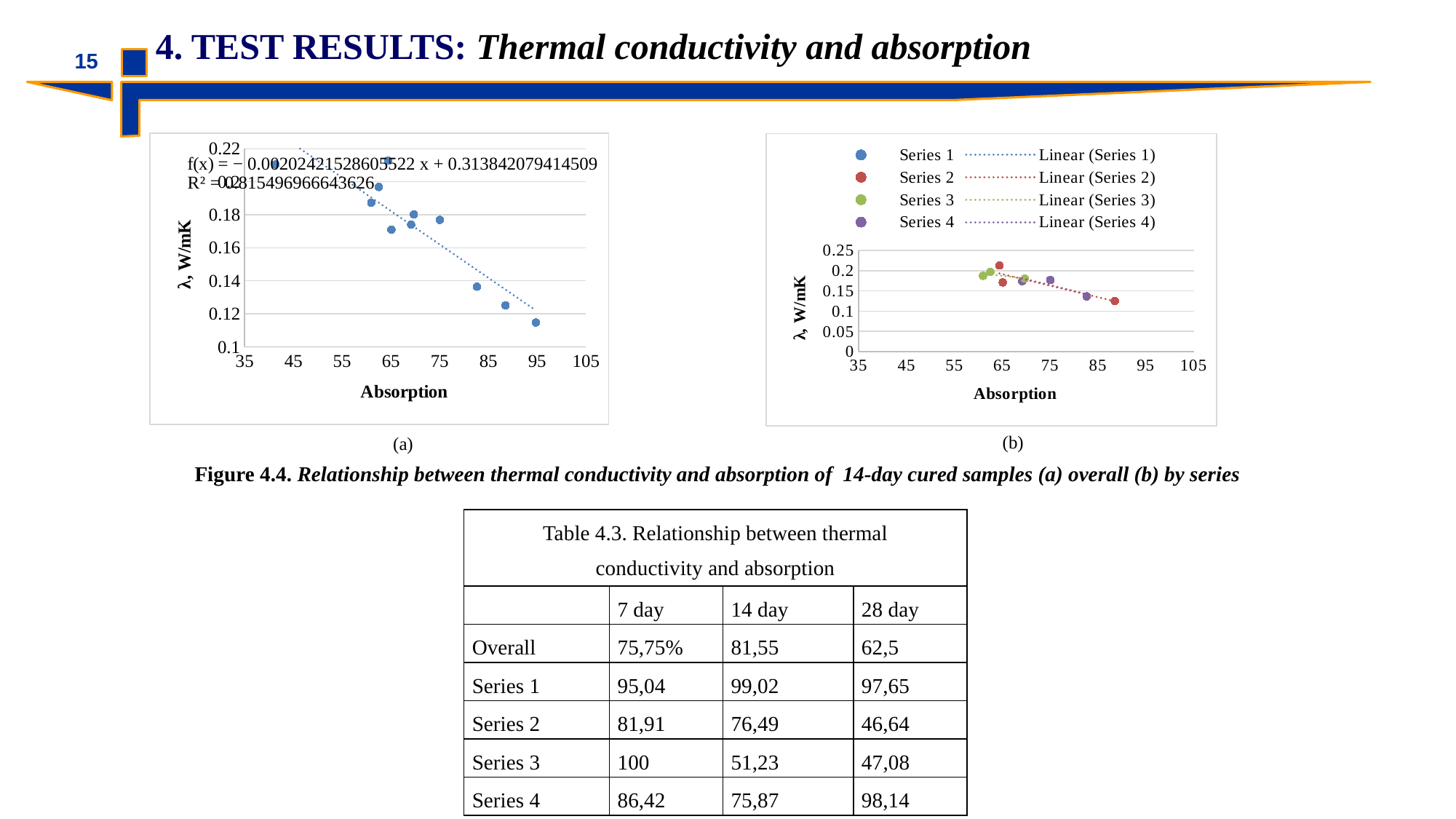
In chart (b), which series contains the point with the lowest thermal conductivity? Series 2 In chart (a), is the value for the highest point near absorption 65 greater or less than 0.2? greater In chart (a), do the thermal conductivity values rise or fall as absorption increases? fall In chart (a), is the slope of the fitted line f(x) positive or negative? negative What is the x-axis title of chart (a)? Absorption In chart (b), is the value for the Series 2 point at absorption about 88 greater or less than 0.15? less In chart (b), do the fitted linear trendlines slope upward or downward as absorption increases? downward What kind of chart is chart (a) on the left? scatter chart How many data series (Series 1 to Series 4) does the legend of chart (b) list? 4 What kind of chart is chart (b) on the right? scatter chart In chart (a), is the value for the point at absorption about 95 greater or less than 0.14? less What is the y-axis title of chart (b)? λ, W/mK